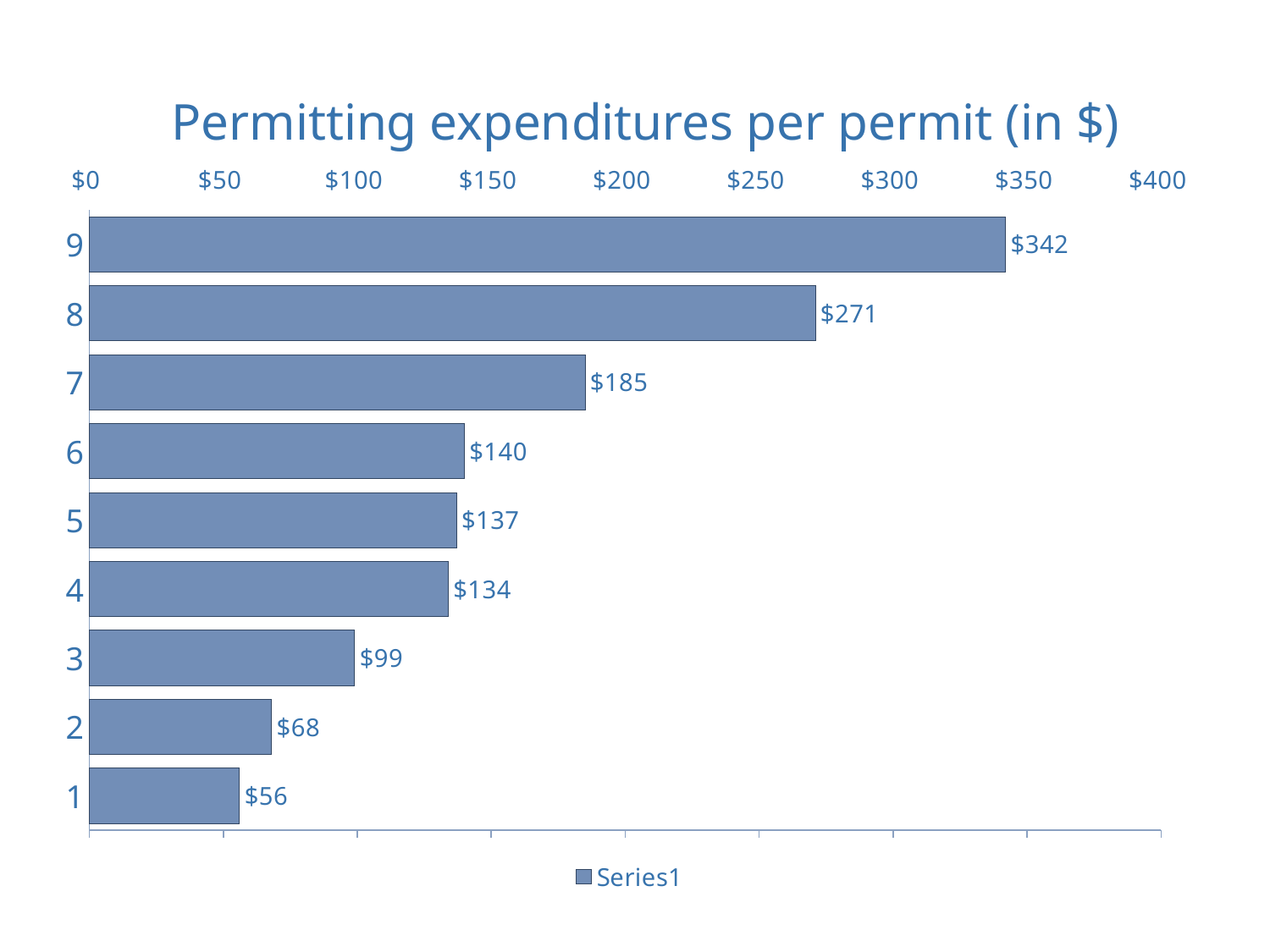
Which is larger, the value for category 8 or the value for category 7? category 8 What kind of chart is shown on the slide? bar chart Which category has the lowest permitting expenditure per permit? 1 What is the title of the chart? Permitting expenditures per permit (in $) Is the value for category 2 greater or less than $100? less What is the permitting expenditure per permit for category 9? $342 What is the value shown for category 3? $99 How many categories are shown in the chart? 9 What is the value shown for category 6? $140 What is the difference between the values for category 9 and category 8? $71 Which category has the highest permitting expenditure per permit? 9 What is the difference between the values for category 7 and category 1? $129